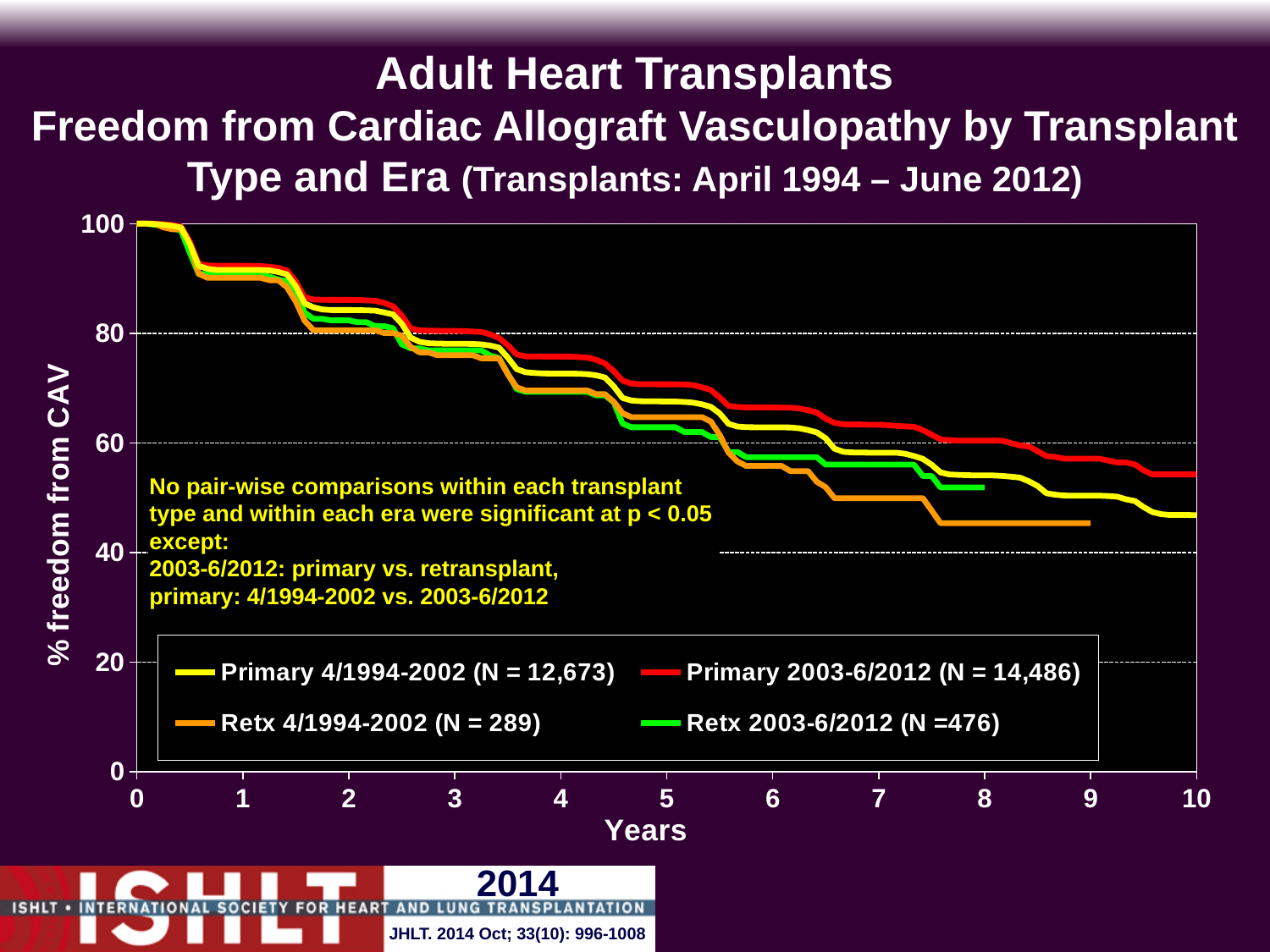
Is the value for Primary 4/1994-2002 at 10 years greater or less than 60? less At 8 years, which series has the higher value: Retx 4/1994-2002 or Retx 2003-6/2012? Retx 2003-6/2012 Is the value for Primary 2003-6/2012 at 10 years greater or less than 40? greater What is the N shown in the legend for Primary 2003-6/2012? 14,486 Is the value for Primary 2003-6/2012 at 10 years greater or less than 60? less At 10 years, which series has the higher value: Primary 4/1994-2002 or Primary 2003-6/2012? Primary 2003-6/2012 How many series does the legend list? 4 Do the curves rise or fall as the number of years increases? fall What kind of chart is shown on the slide? line chart Which series has the lowest value at 8 years? Retx 4/1994-2002